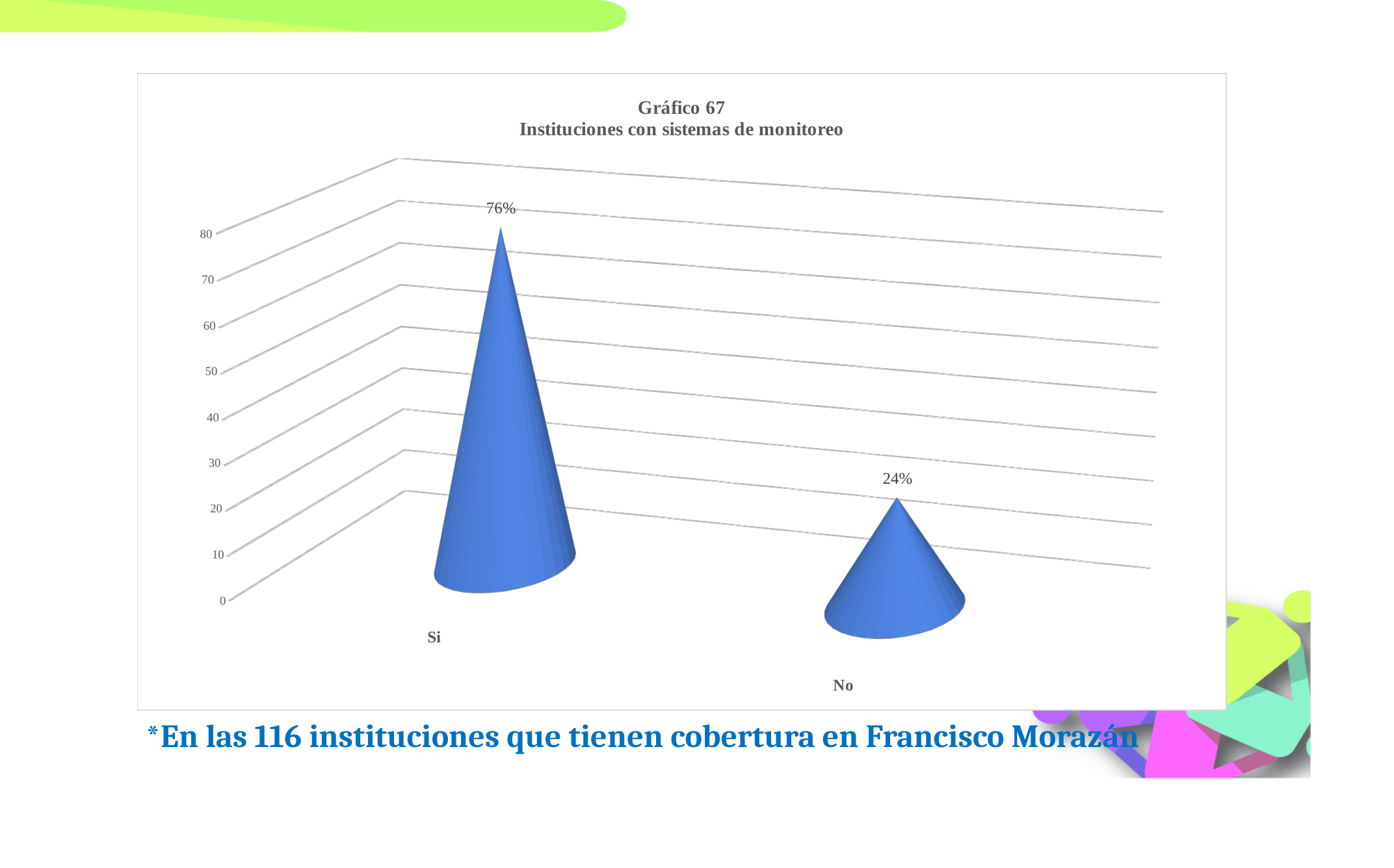
What is the value for Si? 76% Is the value for Si greater or less than 70? greater How many categories are shown on the x axis? 2 What is the value for No? 24% What is the title of the chart? Gráfico 67 Instituciones con sistemas de monitoreo What is the highest value shown on the vertical axis? 80 What kind of chart is shown? bar chart Which category has the lowest value? No Which is larger, the value for Si or the value for No? Si Which category has the highest value? Si Is the value for No greater or less than 30? less What is the difference between the values for Si and No? 52%